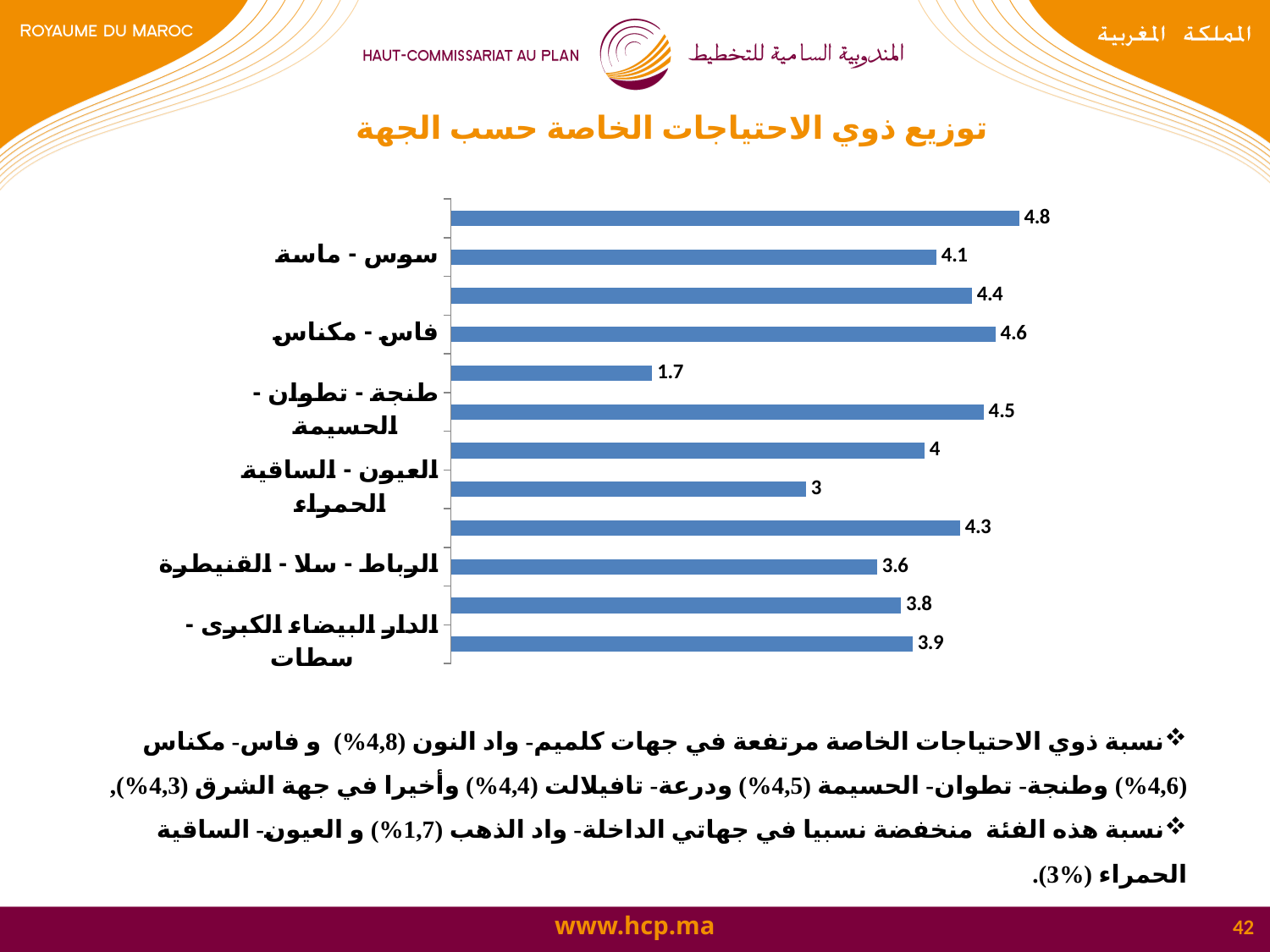
How many bars are plotted on the chart? 12 What is the lowest value shown on the chart? 1.7 What is the value shown for فاس - مكناس? 4.6 What is the difference between the values for فاس - مكناس and سوس - ماسة? 0.5 What is the value shown for العيون - الساقية الحمراء? 3 What is the value shown for طنجة - تطوان - الحسيمة? 4.5 What is the value shown for سوس - ماسة? 4.1 What kind of chart is shown on the slide? Bar chart What is the value shown for الدار البيضاء الكبرى - سطات? 3.9 Which has a larger value, طنجة - تطوان - الحسيمة or العيون - الساقية الحمراء? طنجة - تطوان - الحسيمة What is the value shown for الرباط - سلا - القنيطرة? 3.6 What is the highest value shown on the chart? 4.8